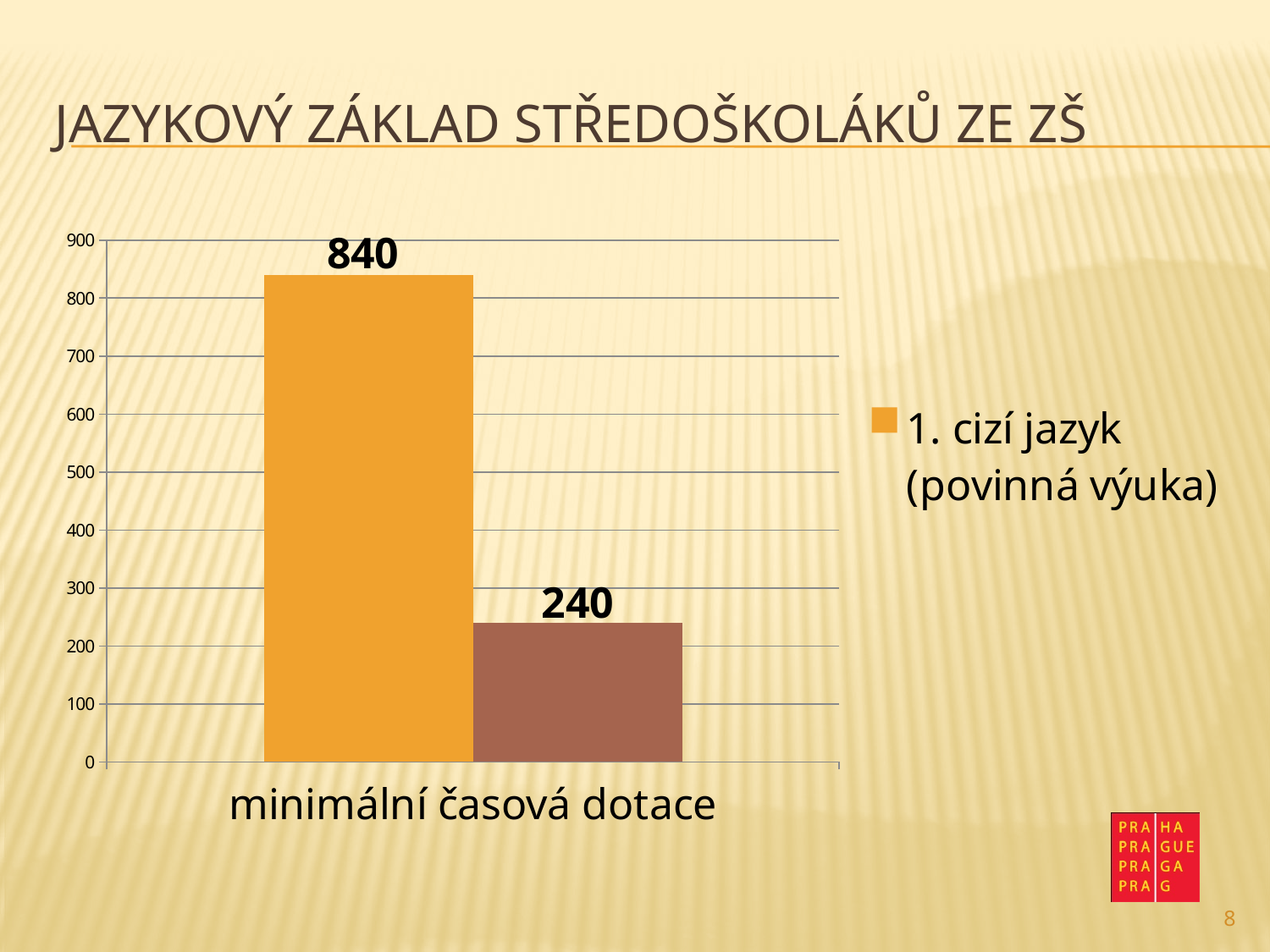
How many series does the legend list? 1 Which bar is the tallest in the chart? 1. cizí jazyk (povinná výuka) Which bar has the lowest value, the orange one or the brown one? the brown one Is the value of the brown bar greater or less than 300? less What is the value of the bar for "1. cizí jazyk (povinná výuka)"? 840 How many categories are shown on the x axis of the chart? 1 What value is printed on the brown bar? 240 What is the category label shown on the x axis? minimální časová dotace What is the difference between the orange bar (840) and the brown bar (240)? 600 Which is larger, the orange bar or the brown bar? the orange bar Is the value for "1. cizí jazyk (povinná výuka)" greater or less than 800? greater What kind of chart is shown on the slide? bar chart